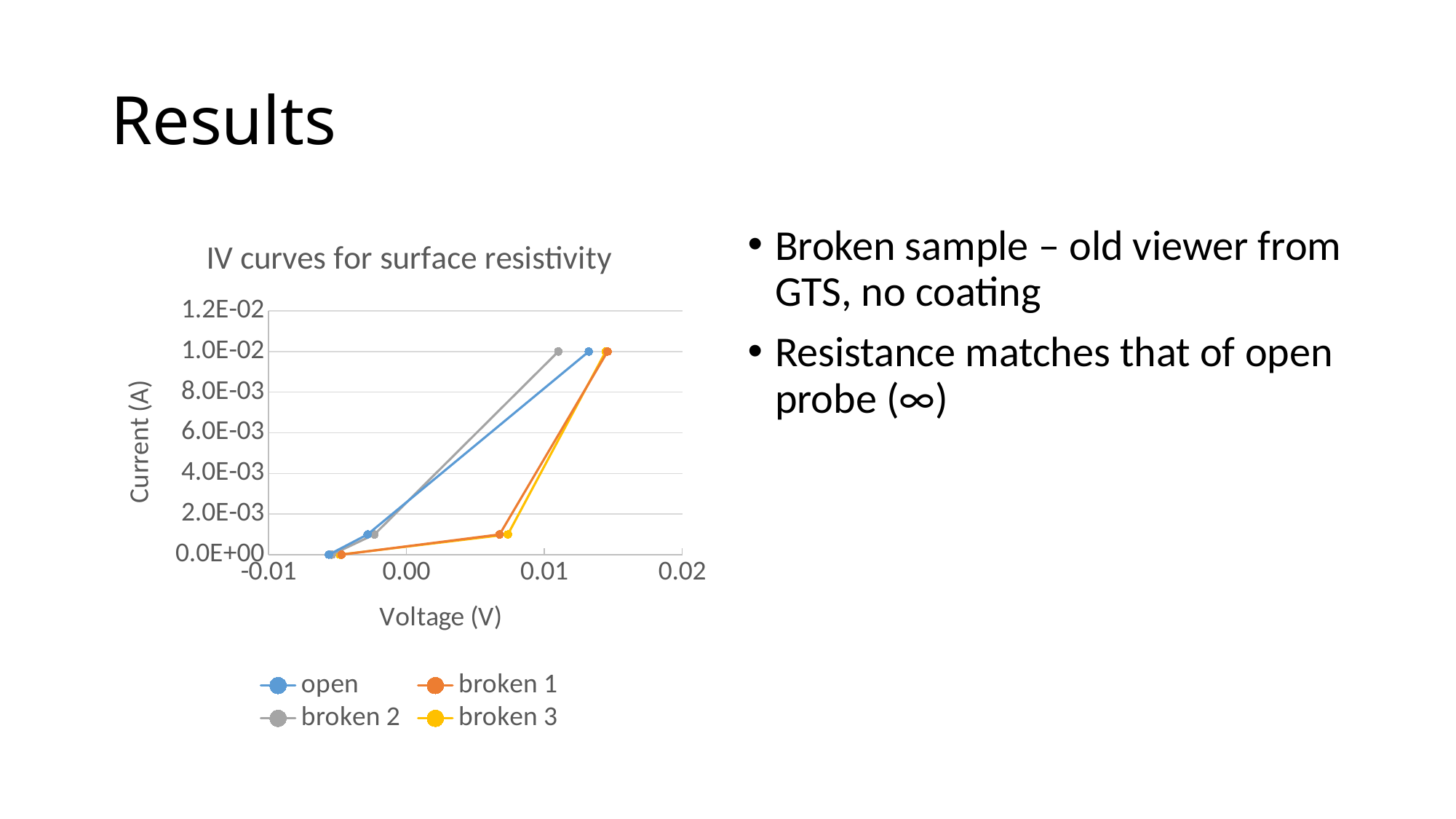
Is the voltage at which 'broken 1' reaches 1.0E-02 A greater or less than 0.01 V? greater What is the title of the chart? IV curves for surface resistivity Is the current of the middle point of the 'broken 3' series greater or less than 2.0E-03 A? less Does the current rise or fall as voltage increases along the x axis? rise Which series reaches 1.0E-02 A at a higher voltage, 'open' or 'broken 2'? open What is the lowest current value plotted for the 'broken 1' series? 0.0E+00 What is the label of the y axis? Current (A) What kind of chart is shown on the slide? line chart Is the voltage of the lowest point of the 'open' series greater or less than 0.00 V? less How many data points are plotted for the 'open' series? 3 What is the highest current value reached by the 'open' series? 1.0E-02 How many series does the legend list? 4